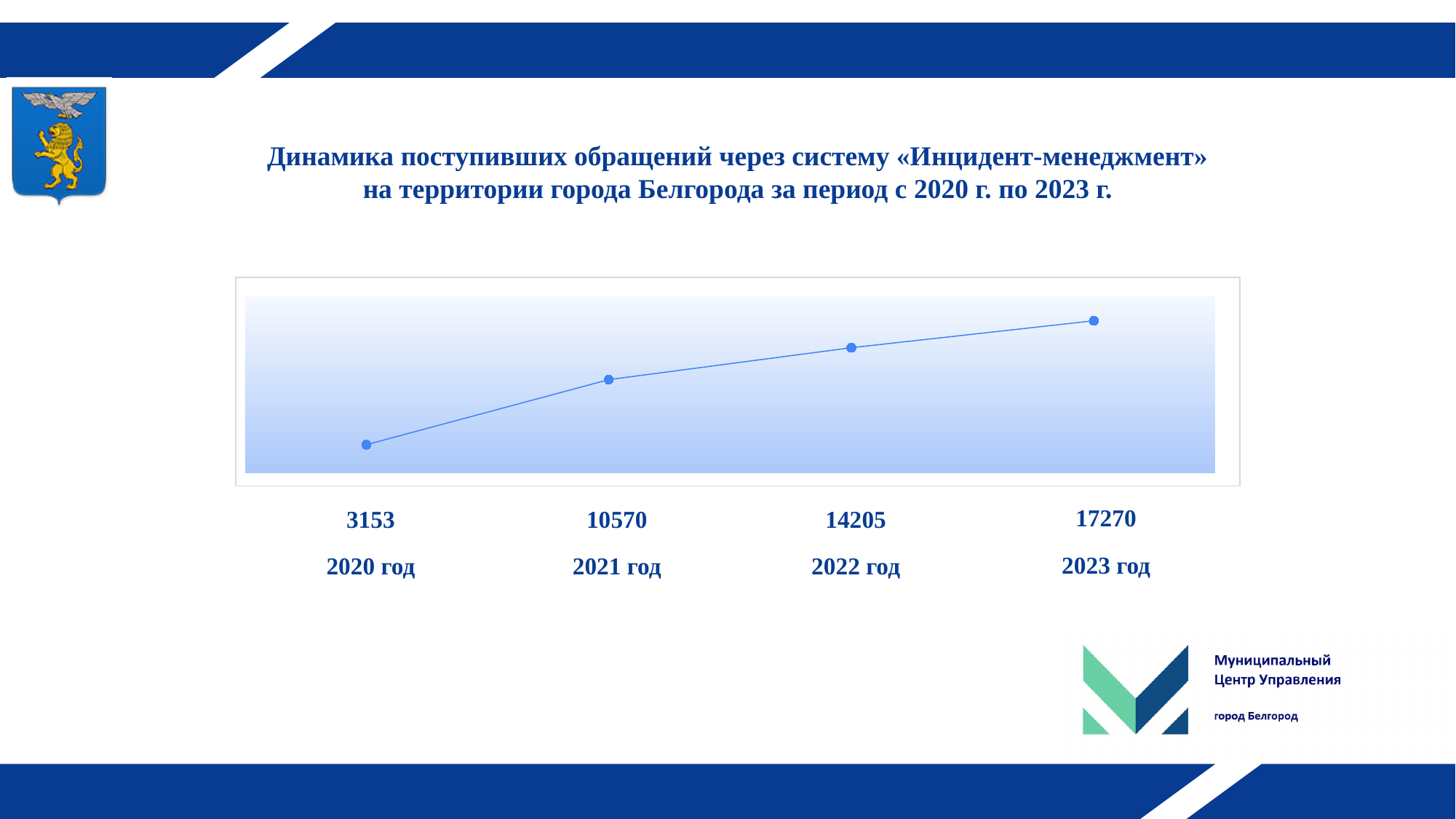
What is the value for 2023 год? 17270 Which year has the lowest value? 2020 год Do the values rise or fall from 2020 год to 2023 год? rise Which year has the highest value? 2023 год What is the value for 2021 год? 10570 What is the value for 2022 год? 14205 What is the difference between the values for 2023 год and 2020 год? 14117 What kind of chart is shown on the slide? line chart How many data points are plotted on the chart? 4 What is the difference between the values for 2021 год and 2020 год? 7417 Which is larger, the value for 2022 год or the value for 2021 год? 2022 год What is the value for 2020 год? 3153